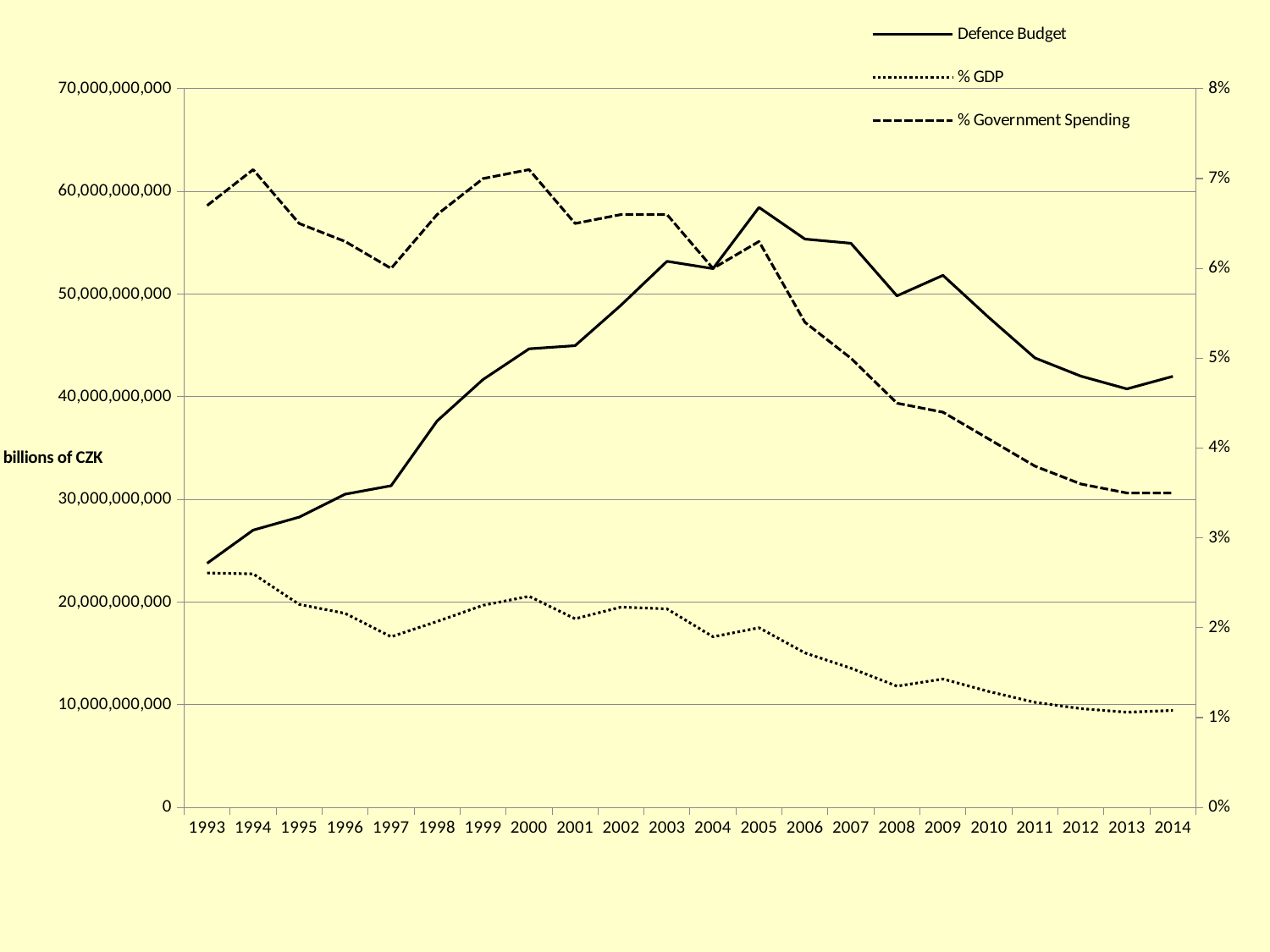
Is the % GDP value for 1993 greater or less than 2%? greater How many series does the legend list? 3 How many years are plotted along the x axis? 22 In which year is the Defence Budget at its lowest? 1993 Is the Defence Budget value for 1993 greater or less than 30,000,000,000? less What kind of chart is shown on the slide? line chart Is the Defence Budget value for 2005 greater or less than 50,000,000,000? greater Which is larger, the Defence Budget in 1998 or in 2003? 2003 In which year does the Defence Budget line reach its highest value? 2005 Does the % GDP line generally rise or fall from 1993 to 2014? fall What label is shown on the left vertical axis? billions of CZK